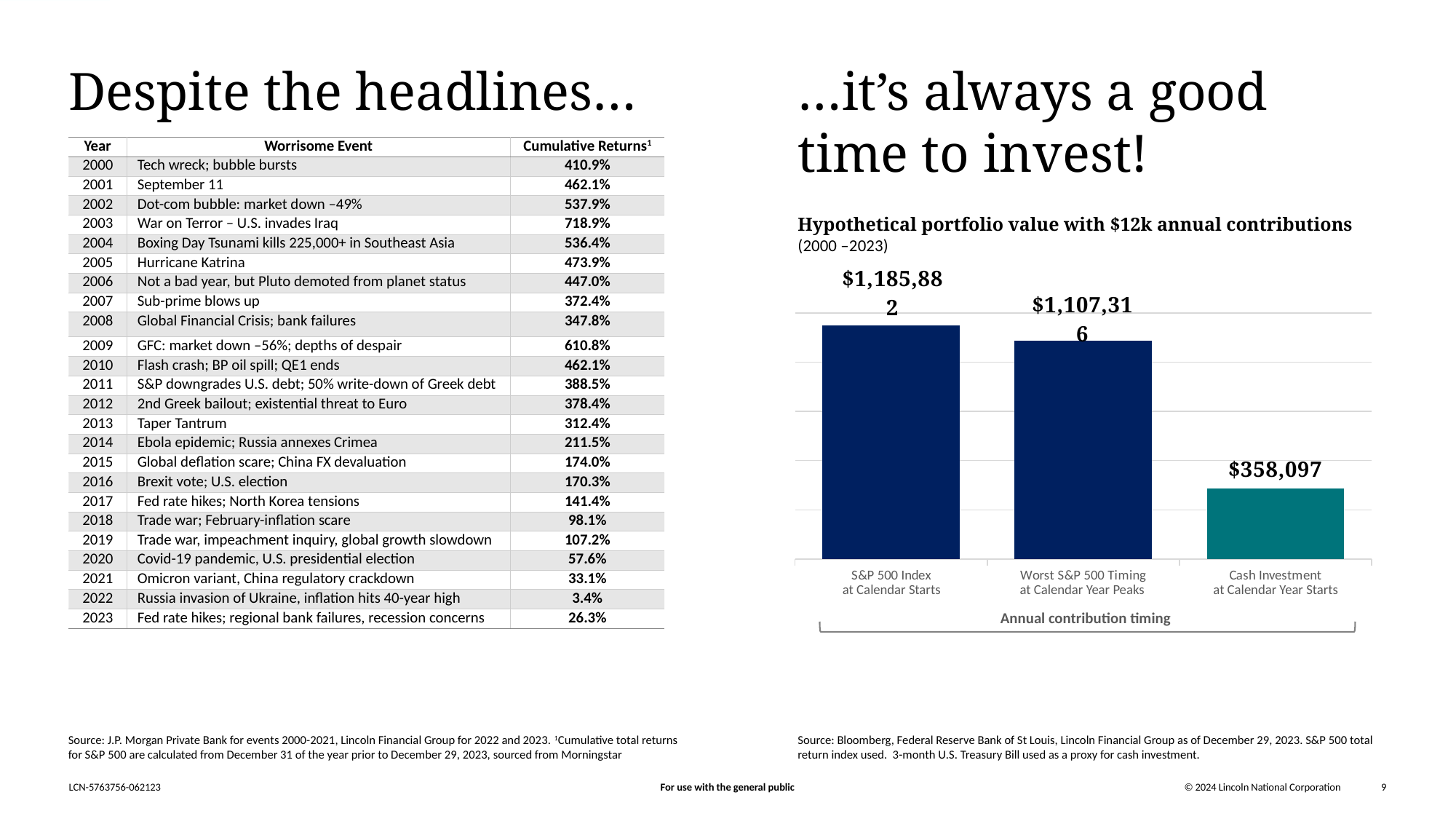
Which is larger: the portfolio value for Worst S&P 500 Timing at Calendar Year Peaks or for Cash Investment at Calendar Year Starts? Worst S&P 500 Timing at Calendar Year Peaks What is the hypothetical portfolio value for Worst S&P 500 Timing at Calendar Year Peaks? $1,107,316 How many contribution timing categories are shown in the chart? 3 What is the hypothetical portfolio value for S&P 500 Index at Calendar Starts? $1,185,882 What is the hypothetical portfolio value for Cash Investment at Calendar Year Starts? $358,097 Which contribution timing has the highest hypothetical portfolio value? S&P 500 Index at Calendar Starts What is the difference between the portfolio values for S&P 500 Index at Calendar Starts and Cash Investment at Calendar Year Starts? $827,785 What kind of chart is used to show the hypothetical portfolio values? Bar chart What is the difference between the portfolio values for Worst S&P 500 Timing at Calendar Year Peaks and Cash Investment at Calendar Year Starts? $749,219 What is the difference between the portfolio values for S&P 500 Index at Calendar Starts and Worst S&P 500 Timing at Calendar Year Peaks? $78,566 Which contribution timing has the lowest hypothetical portfolio value? Cash Investment at Calendar Year Starts What is the title of the chart on the right side of the slide? Hypothetical portfolio value with $12k annual contributions